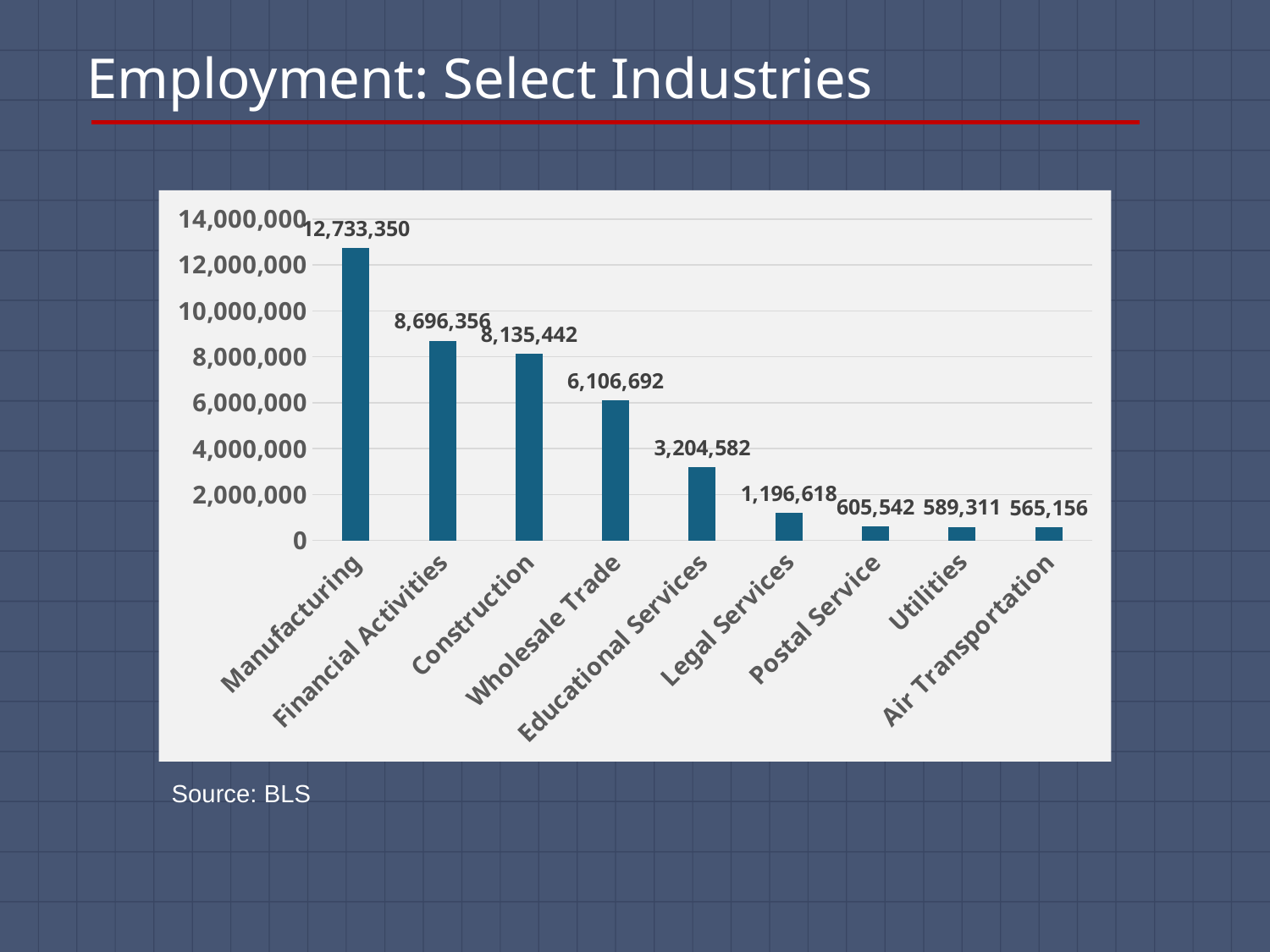
What is the employment value for Wholesale Trade? 6,106,692 What is the employment value for Legal Services? 1,196,618 Do the employment values rise or fall from left to right across the industries? Fall Which industry has the highest employment? Manufacturing What is the employment value for Utilities? 589,311 Which industry has the lowest employment? Air Transportation Which has higher employment, Financial Activities or Construction? Financial Activities What is the employment value for Manufacturing? 12,733,350 What is the difference in employment between Construction and Wholesale Trade? 2,028,750 What is the difference in employment between Manufacturing and Financial Activities? 4,036,994 What kind of chart is shown on the slide? Bar chart How many industries are shown in the chart? 9